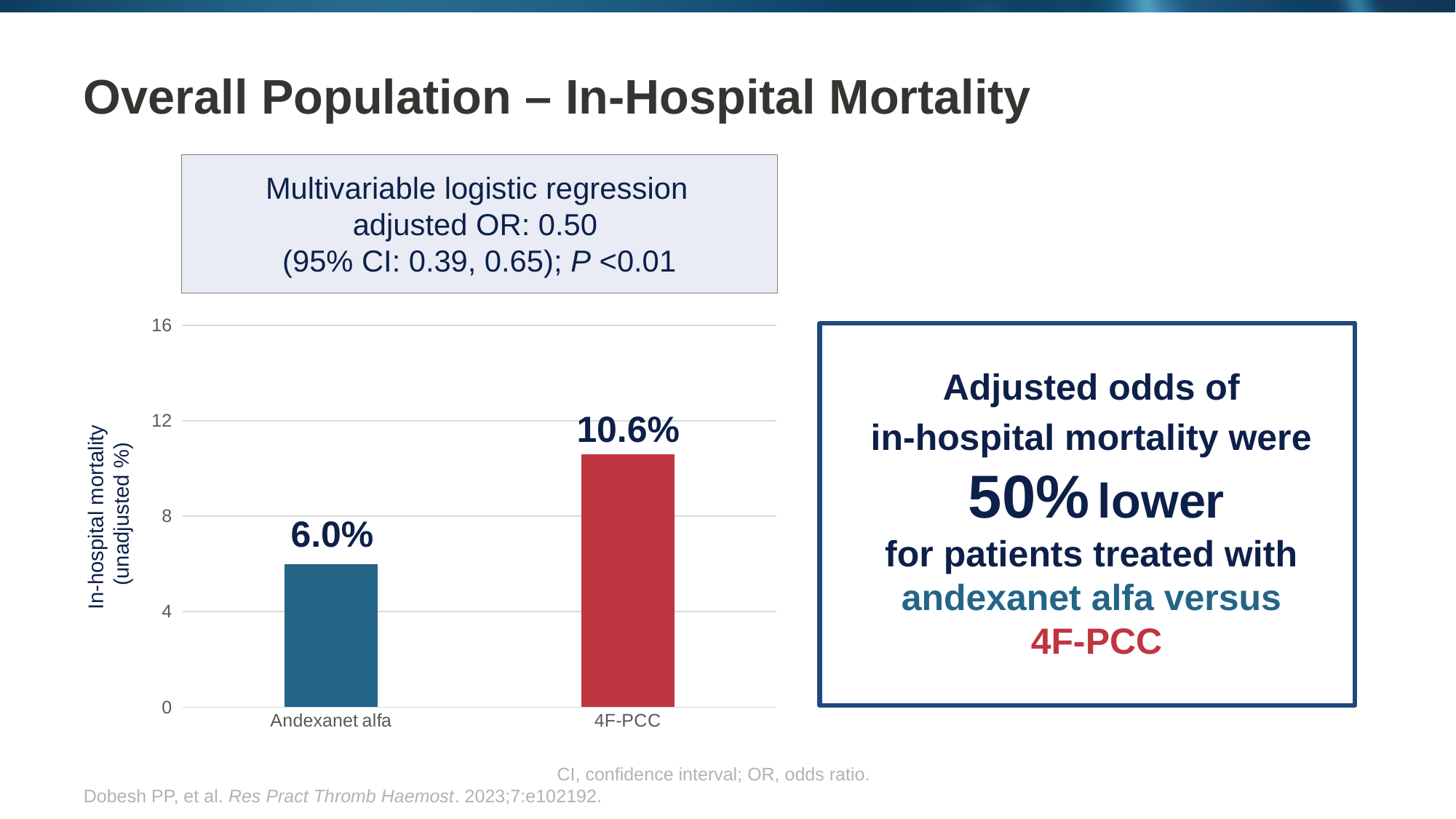
Is the value for 4F-PCC greater or less than 8? greater What is the label of the y axis of the chart? In-hospital mortality (unadjusted %) Which category has the highest in-hospital mortality? 4F-PCC What is the in-hospital mortality value for 4F-PCC? 10.6% Which has a larger in-hospital mortality value, Andexanet alfa or 4F-PCC? 4F-PCC Which category has the lowest in-hospital mortality? Andexanet alfa How many categories are shown on the chart? 2 What is the in-hospital mortality value for Andexanet alfa? 6.0% Is the value for Andexanet alfa greater or less than 8? less What is the maximum value shown on the y axis of the chart? 16 What kind of chart is shown on the slide? Bar chart What is the difference in in-hospital mortality between 4F-PCC and Andexanet alfa? 4.6%